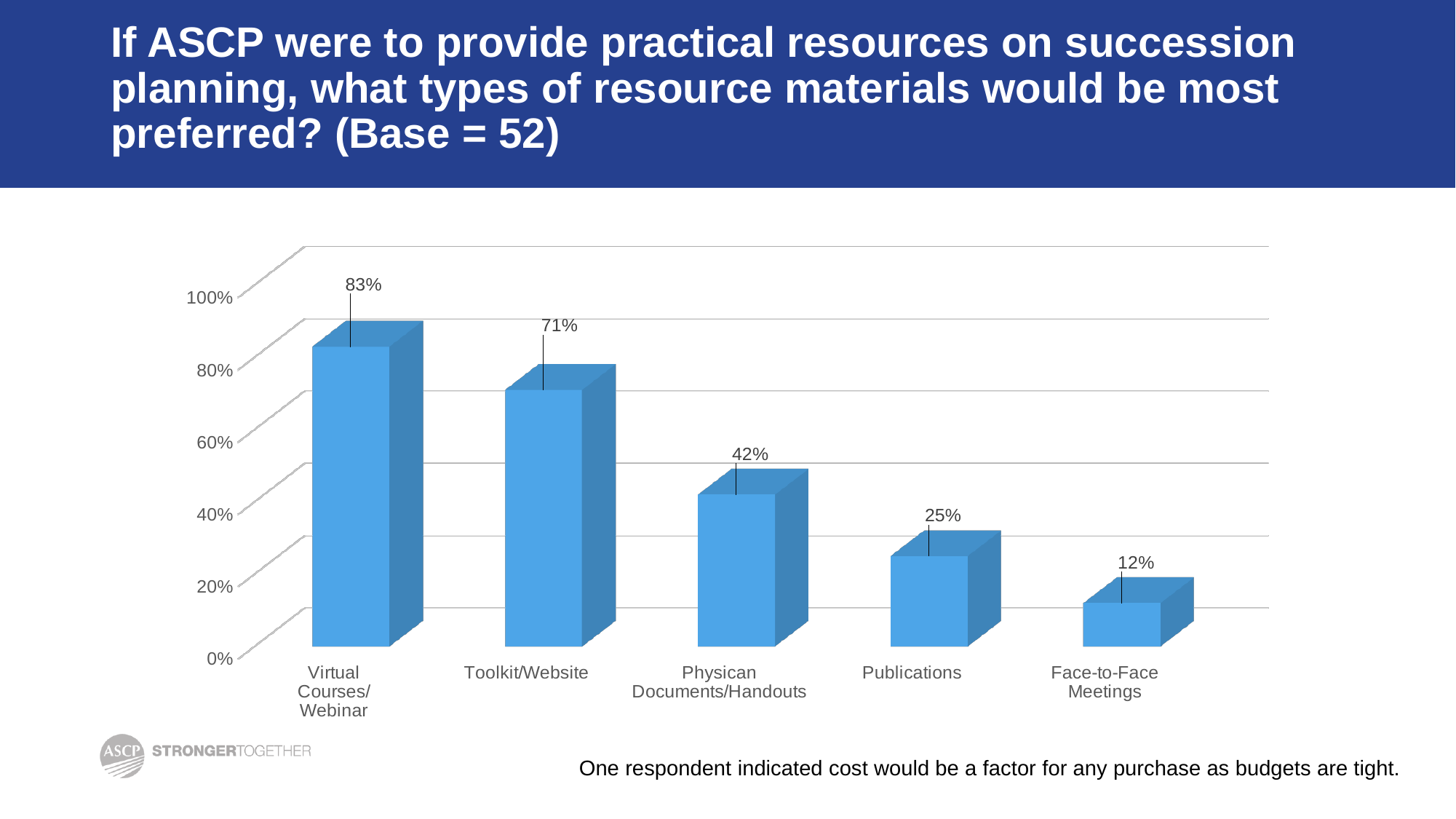
What is the value shown for Toolkit/Website? 71% What percentage of respondents preferred Virtual Courses/Webinar? 83% What percentage is shown for Physican Documents/Handouts? 42% What kind of chart is shown on the slide? Bar chart What is the difference between the values for Virtual Courses/Webinar and Toolkit/Website? 12% What is the value for Face-to-Face Meetings? 12% What is the difference between the values for Publications and Face-to-Face Meetings? 13% Which resource type has the highest percentage? Virtual Courses/Webinar How many resource types are shown on the chart? 5 Do the values rise or fall from left to right across the categories? Fall Which resource type has the lowest percentage? Face-to-Face Meetings Which is larger, the value for Physican Documents/Handouts or the value for Publications? Physican Documents/Handouts